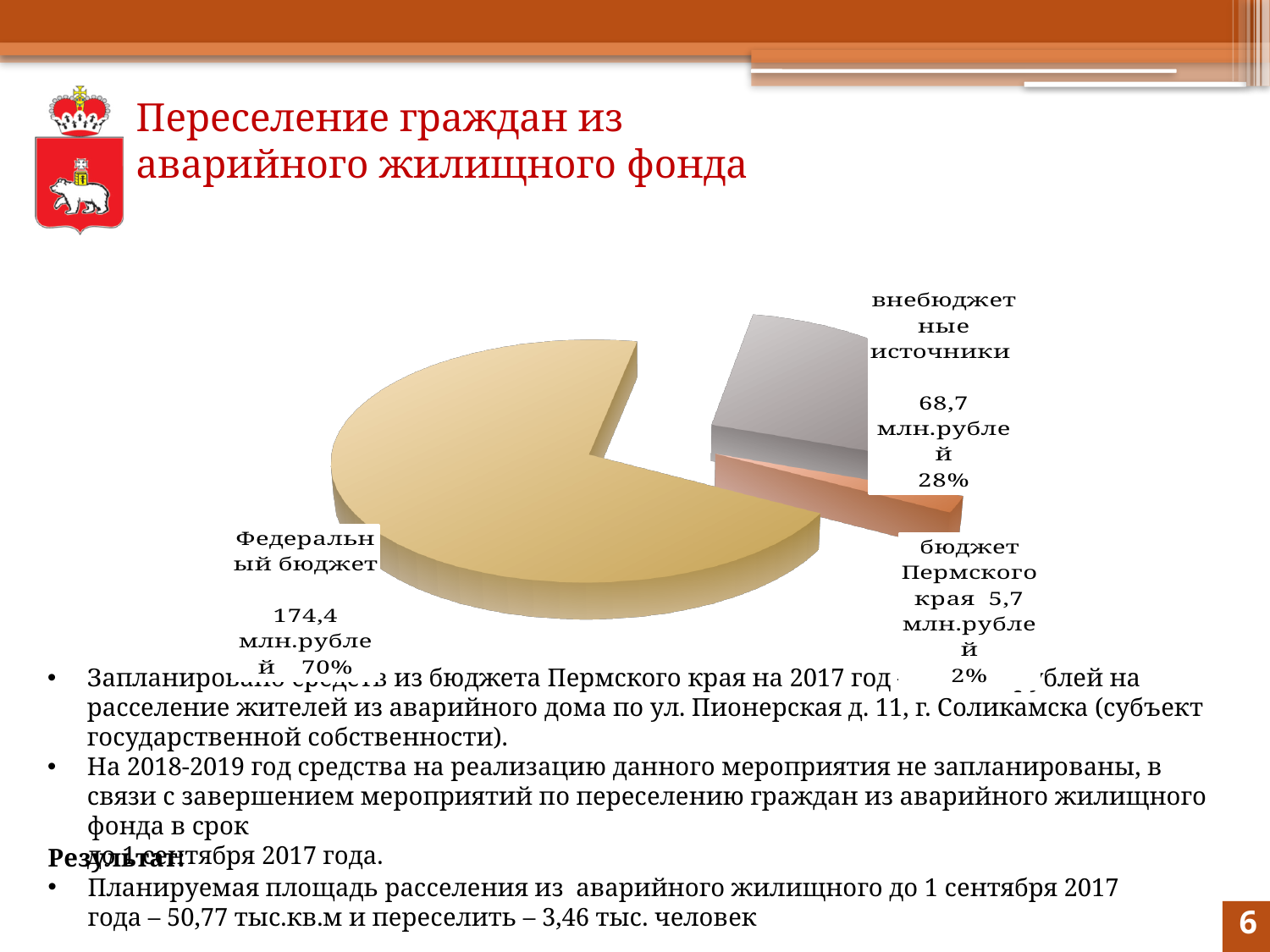
Which slice of the pie is the smallest? бюджет Пермского края How many slices does the pie chart have? 3 What value is shown for внебюджетные источники? 68,7 млн.рублей What value is shown for Федеральный бюджет? 174,4 млн.рублей Which slice of the pie is the largest? Федеральный бюджет What share of the pie does бюджет Пермского края take? 2% What share of the pie does внебюджетные источники take? 28% What value is shown for бюджет Пермского края? 5,7 млн.рублей Which is larger, внебюджетные источники or бюджет Пермского края? внебюджетные источники What share of the pie does Федеральный бюджет take? 70% What kind of chart is shown on the slide? pie chart What is the difference between the values for Федеральный бюджет and внебюджетные источники? 105,7 млн.рублей